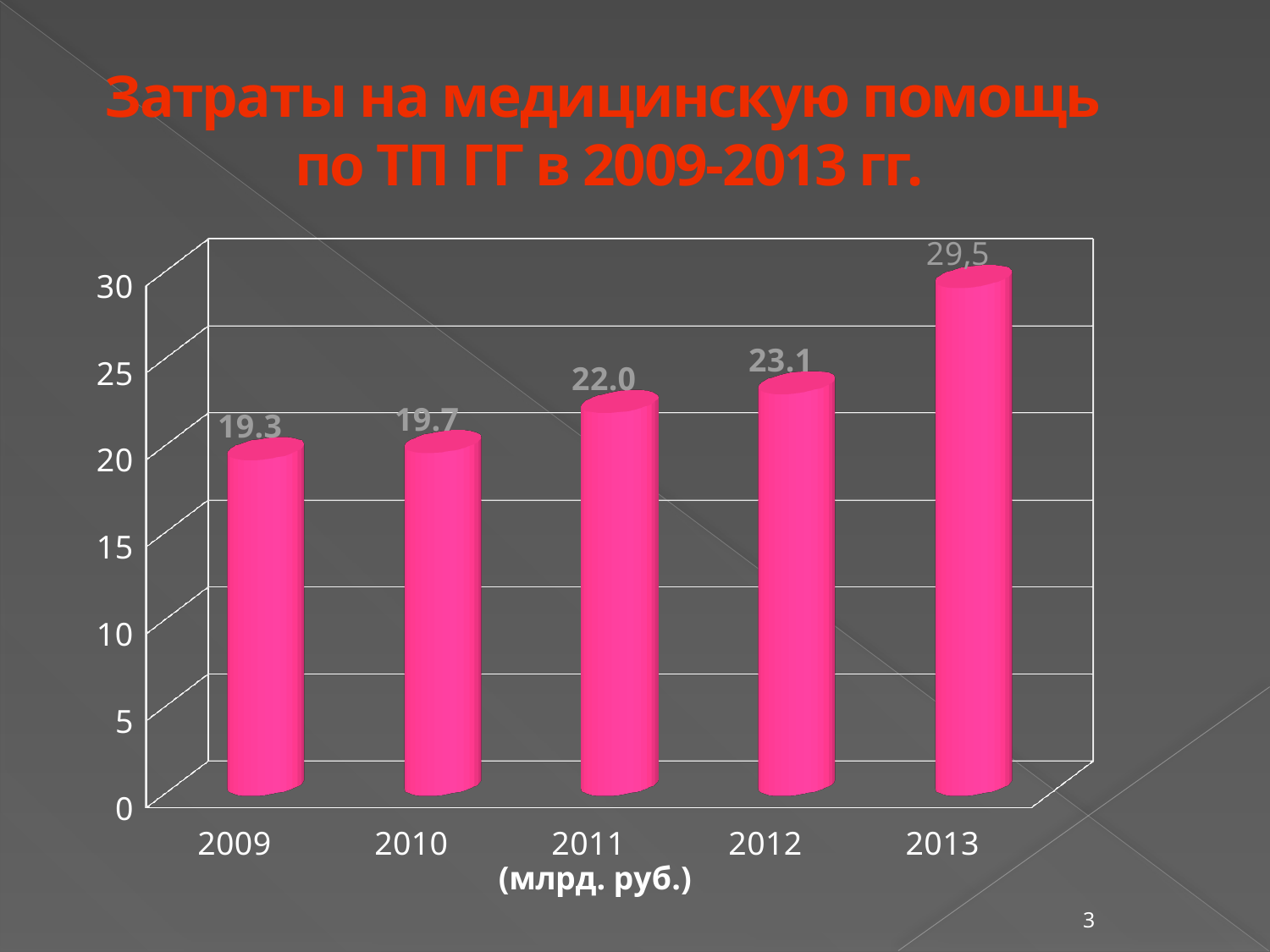
What is the value for 2012? 23.1 What is the value for 2011? 22.0 What is the value for 2009? 19.3 What is the difference between the values for 2012 and 2011? 1.1 How many years are shown on the x axis? 5 Which year has the highest value? 2013 Do the values rise or fall from 2009 to 2013? rise What kind of chart is shown on the slide? bar chart What is the difference between the values for 2010 and 2009? 0.4 What is the value for 2013? 29,5 Which year has the lowest value? 2009 Which is larger, the value for 2011 or the value for 2013? 2013